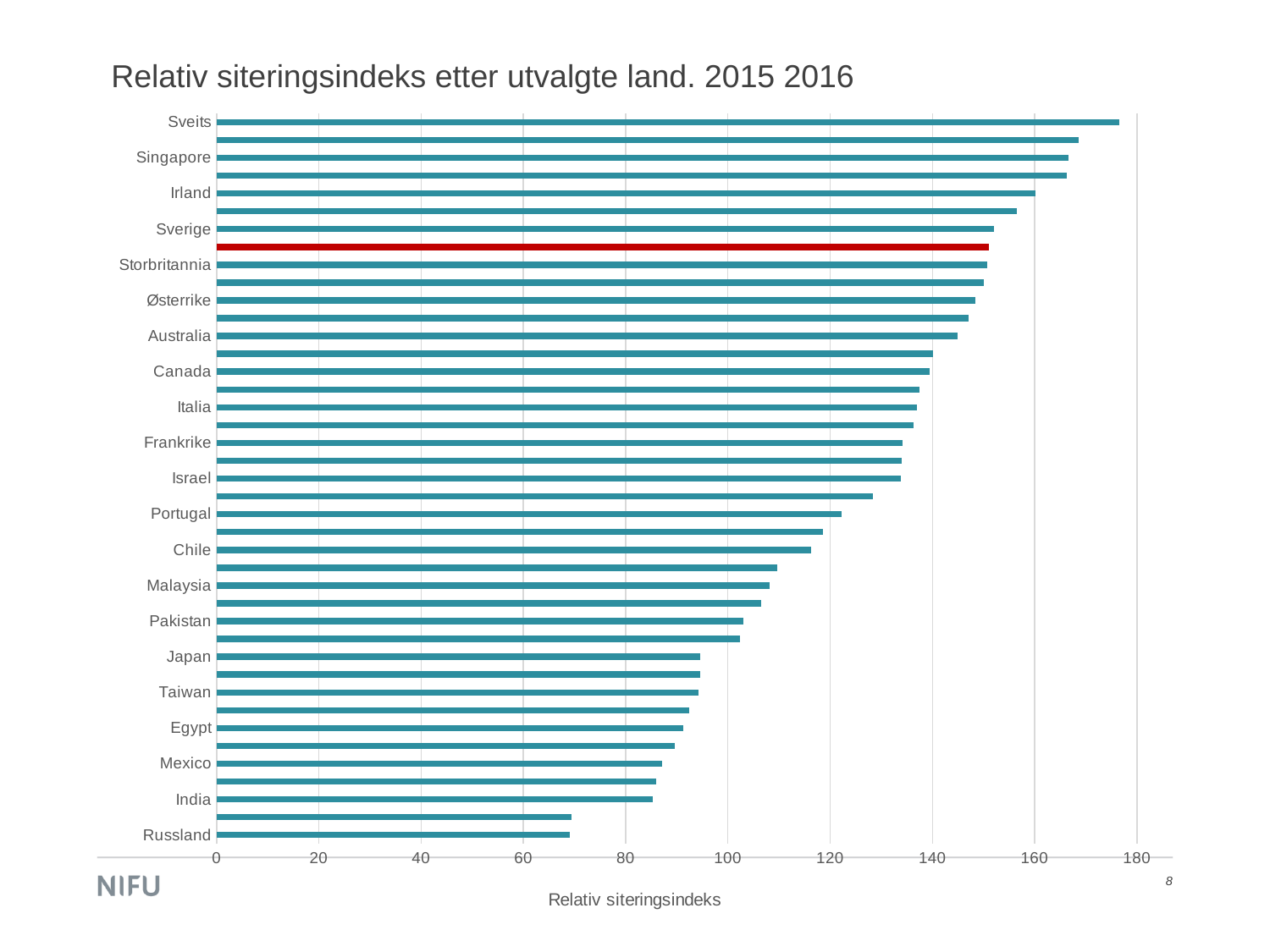
Is the value for Irland greater or less than 140? greater Which country has the highest relative citation index in the chart? Sveits What is the title of the chart? Relativ siteringsindeks etter utvalgte land. 2015 2016 Is the value for Sveits greater or less than 160? greater Do the bar values increase or decrease going from the top of the chart to the bottom? decrease What kind of chart is shown on the slide? Bar chart Which country has the lowest relative citation index in the chart? Russland Which has a higher relative citation index, Singapore or Japan? Singapore Is the value for Russland greater or less than 80? less Which has a higher relative citation index, Australia or Mexico? Australia